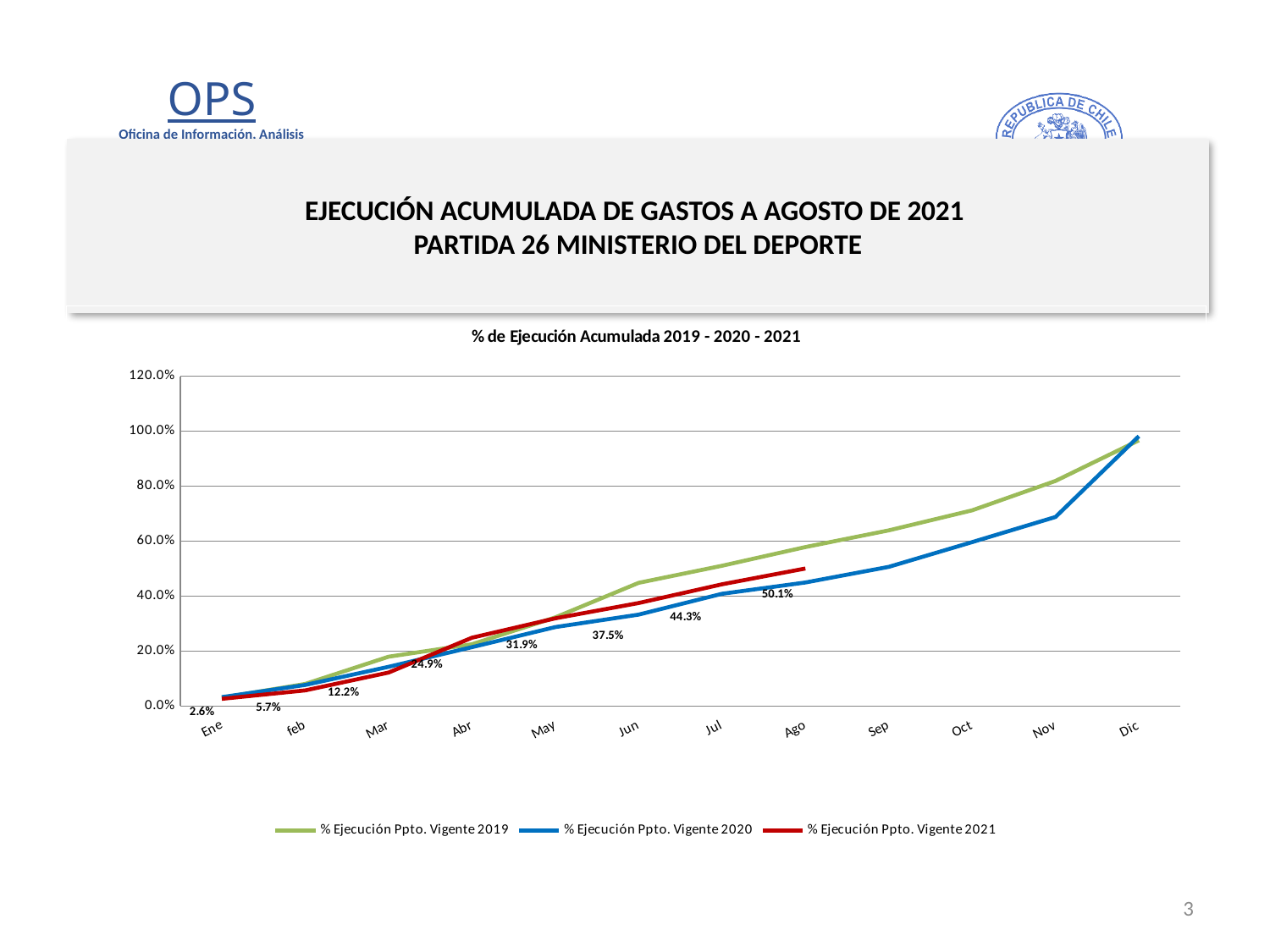
Does the % Ejecución Ppto. Vigente 2021 series rise or fall from Ene to Ago? rise Is the value for % Ejecución Ppto. Vigente 2019 in Nov greater or less than 60.0%? greater What is the difference between the 2021 values for Ago and Jul? 5.8% What is the difference between the 2021 values for Mar and Feb? 6.5% What is the value of % Ejecución Ppto. Vigente 2021 in Ene? 2.6% How many months are shown on the x axis? 12 What is the value of % Ejecución Ppto. Vigente 2021 in Ago? 50.1% What type of chart is shown on the slide? line chart How many series does the legend list? 3 What is the value of % Ejecución Ppto. Vigente 2021 in Abr? 24.9% Which series has the higher value in Oct, % Ejecución Ppto. Vigente 2019 or % Ejecución Ppto. Vigente 2020? % Ejecución Ppto. Vigente 2019 What is the title of the chart? % de Ejecución Acumulada 2019 - 2020 - 2021